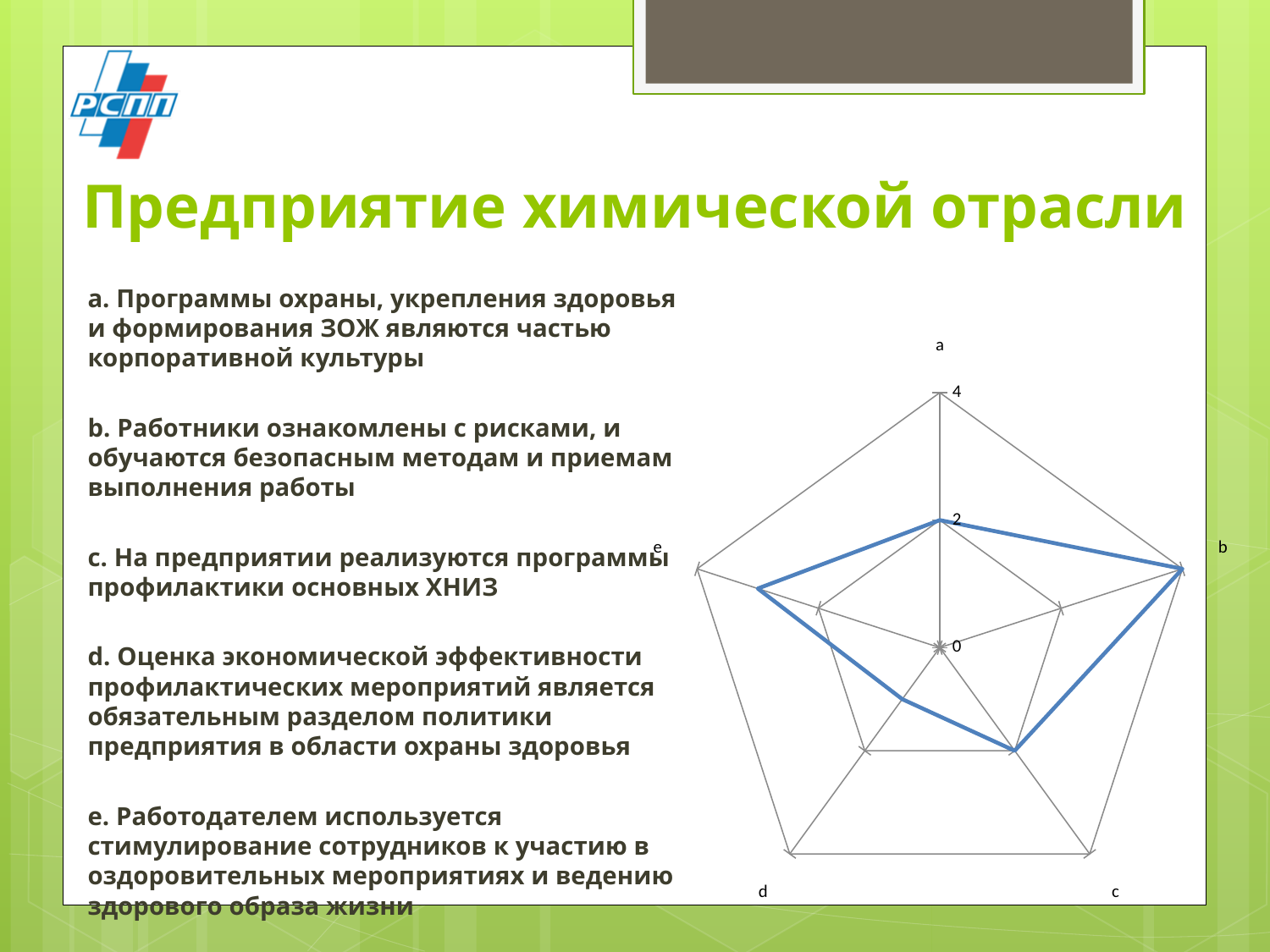
What is the value for category c on the radar chart? 2 Which is larger, the value for b or the value for d? b What kind of chart is shown on the slide? radar chart What is the value for category a on the radar chart? 2 How many categories (axes) does the radar chart have? 5 Is the value for category d greater or less than 2? less Is the value for category e greater or less than 2? greater Which category has the lowest value on the radar chart? d What is the difference between the values for b and a? 2 What is the value for category b on the radar chart? 4 What is the maximum value shown on the radar chart's axis scale? 4 Which category has the highest value on the radar chart? b